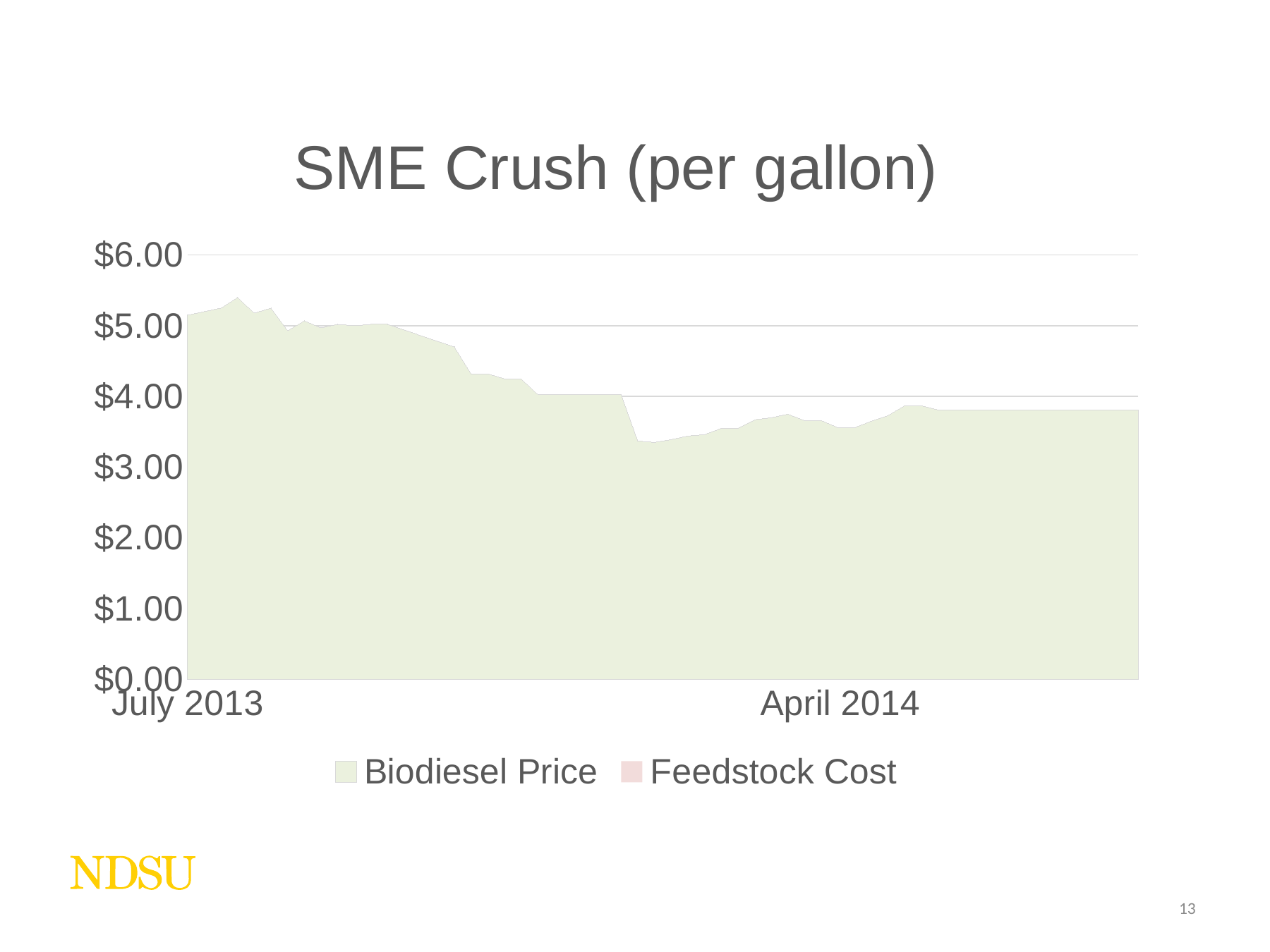
What kind of chart is shown on the slide? area chart Is the lowest point of the Biodiesel Price greater or less than $3.00? greater Is the highest point of the Biodiesel Price greater or less than $6.00? less Is the Biodiesel Price at July 2013 greater or less than $5.00? greater What are the two series named in the legend? Biodiesel Price and Feedstock Cost What is the highest value shown on the vertical axis? $6.00 Which is larger, the Biodiesel Price at July 2013 or at April 2014? July 2013 What is the title of the chart? SME Crush (per gallon) How many series does the legend list? 2 Does the Biodiesel Price generally rise or fall from July 2013 to April 2014? fall